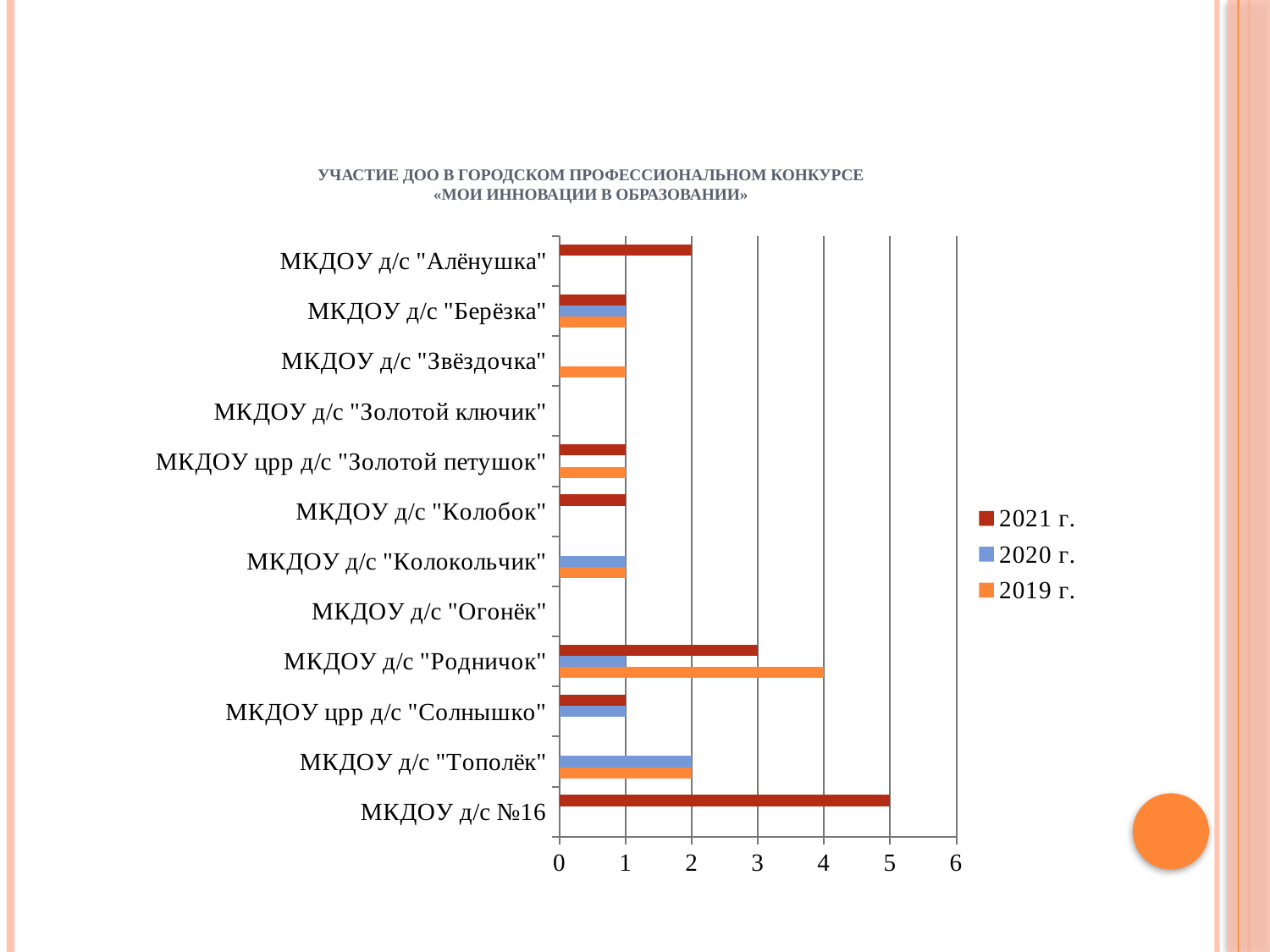
What is the value for МКДОУ д/с "Родничок" in 2019 г.? 4 How many categories (institutions) are shown on the chart? 12 What is the value for МКДОУ д/с "Тополёк" in 2020 г.? 2 Which is larger: the 2021 г. value for МКДОУ д/с "Алёнушка" or the 2021 г. value for МКДОУ д/с "Родничок"? МКДОУ д/с "Родничок" What is the difference between the 2019 г. and 2021 г. values for МКДОУ д/с "Родничок"? 1 What is the value for МКДОУ д/с №16 in 2021 г.? 5 What kind of chart is shown on the slide? bar chart Which institution has the highest value for 2021 г.? МКДОУ д/с №16 How many series does the legend list? 3 Which institution has the highest value for 2019 г.? МКДОУ д/с "Родничок" Which series is shown in orange in the legend? 2019 г. Is the 2021 г. value for МКДОУ д/с №16 greater or less than 4? greater